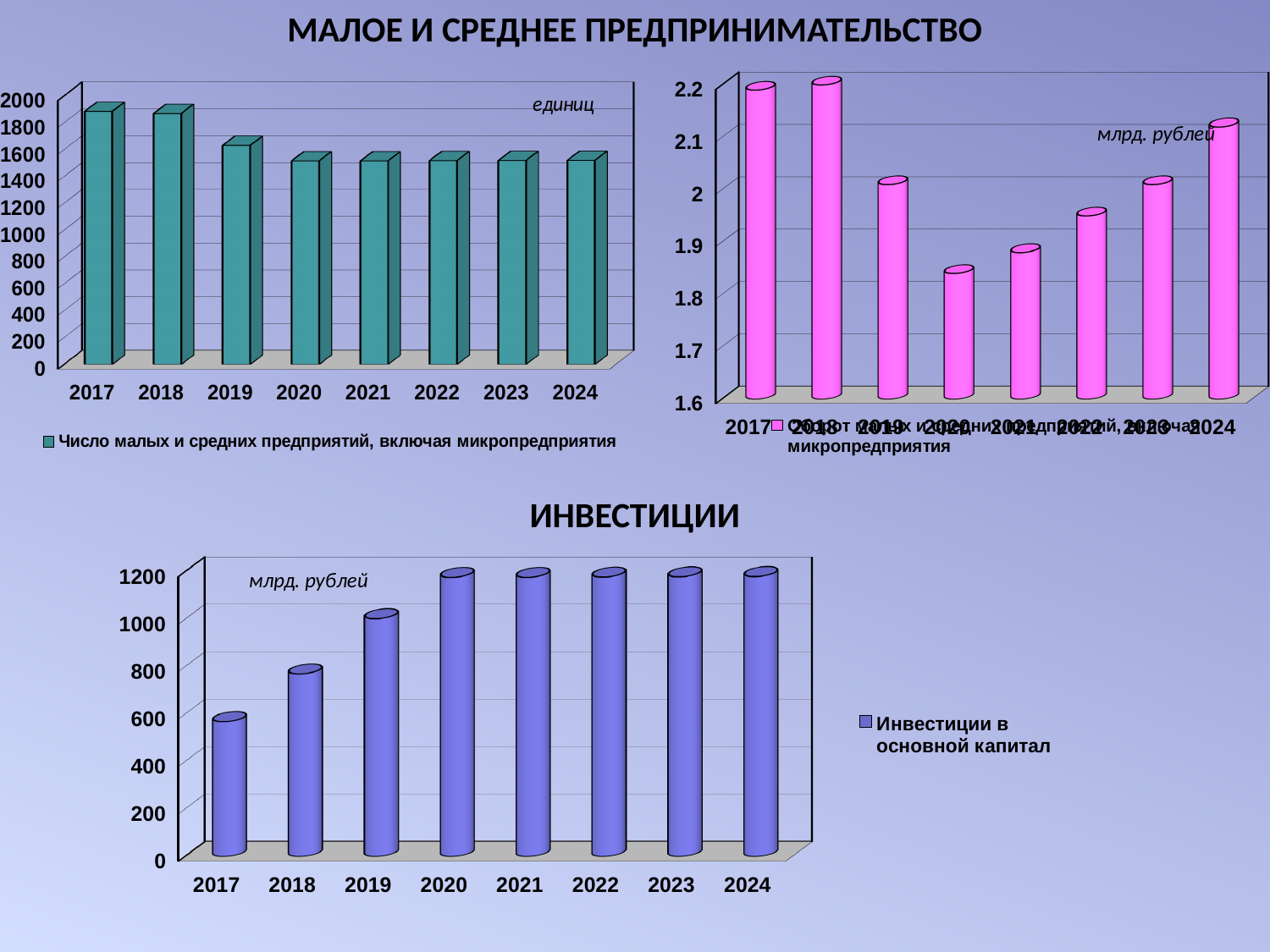
In the top-right chart (млрд. рублей, pink bars), is the value for 2017 greater or less than 2.1? greater What kind of chart is the top-left chart (Число малых и средних предприятий)? bar chart In the top-right chart (млрд. рублей, pink bars), which year has the lowest value? 2020 In the ИНВЕСТИЦИИ chart, is the value for 2020 greater or less than 1000? greater How many years are shown on the x axis of the top-left chart (Число малых и средних предприятий)? 8 In the ИНВЕСТИЦИИ chart, do the values generally rise or fall from 2017 to 2024? rise What series name does the legend of the ИНВЕСТИЦИИ chart show? Инвестиции в основной капитал In the top-left chart (Число малых и средних предприятий), is the value for 2020 greater or less than 1600? less In the top-right chart (млрд. рублей, pink bars), which is larger, the value for 2017 or the value for 2020? 2017 In the top-left chart (Число малых и средних предприятий), do the values generally rise or fall from 2017 to 2024? fall In the ИНВЕСТИЦИИ chart, which year has the lowest value? 2017